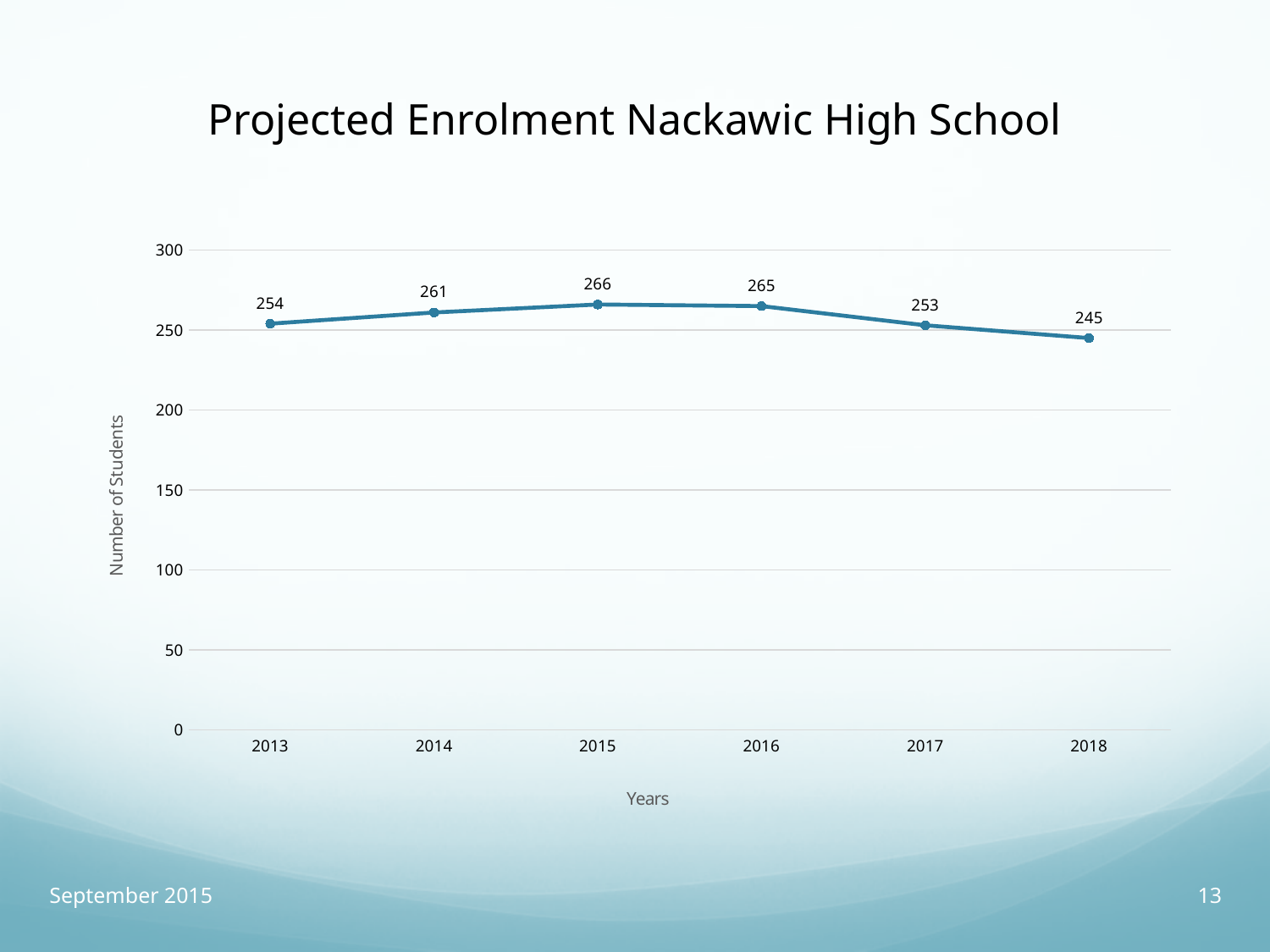
Is the projected enrolment for 2017 greater or less than 250? greater What is the label of the vertical axis? Number of Students What is the projected enrolment for 2018? 245 Which year has the highest projected enrolment? 2015 What is the projected enrolment for 2016? 265 What is the projected enrolment for 2013? 254 Does the projected enrolment rise or fall from 2016 to 2018? Fall Which year has the lowest projected enrolment? 2018 What kind of chart is shown on the slide? Line chart How many years are plotted on the chart? 6 Which year has a larger projected enrolment, 2014 or 2017? 2014 What is the difference between the projected enrolment in 2015 and in 2018? 21